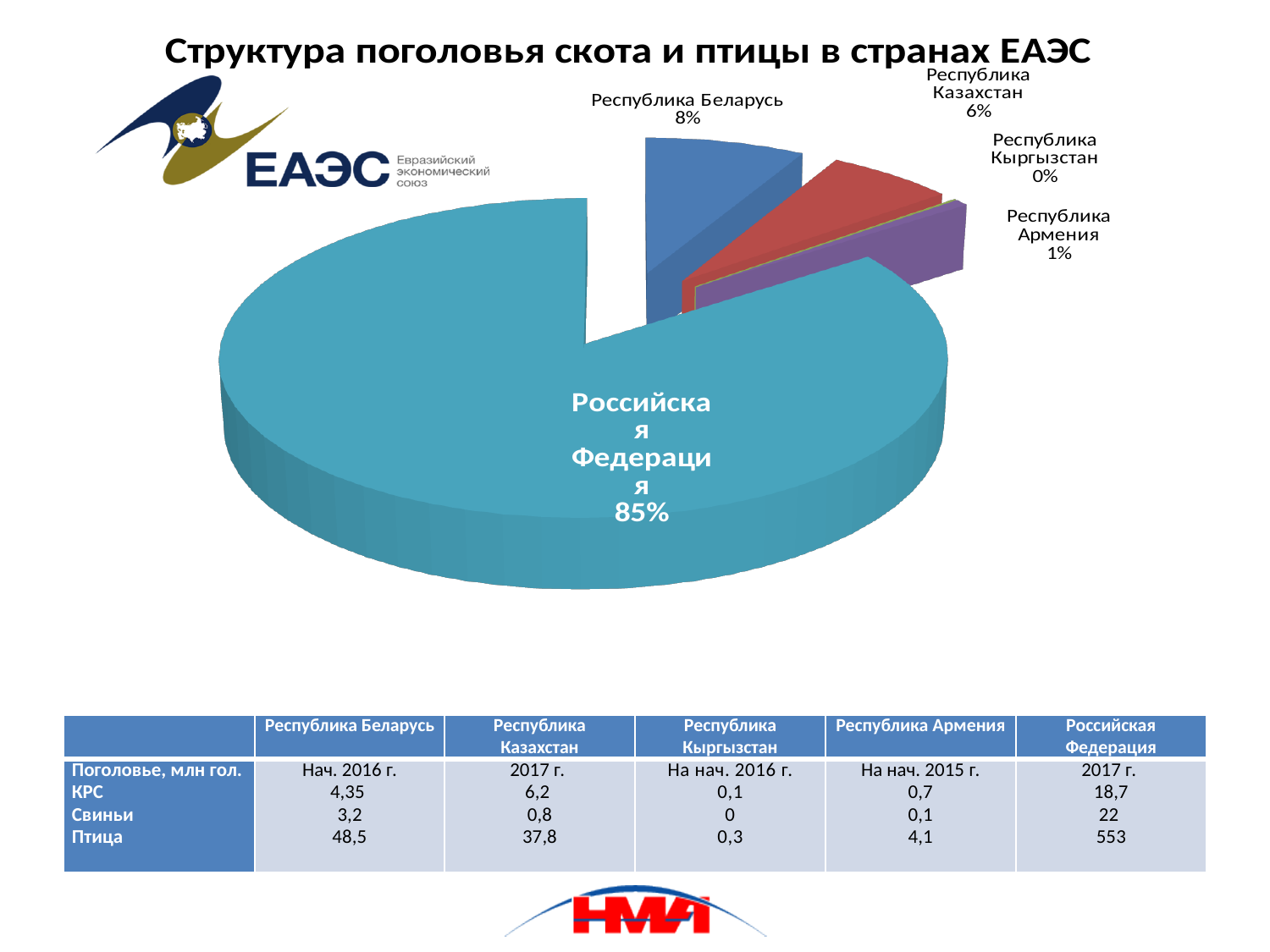
What is the difference in percentage points between the shares of Республика Беларусь and Республика Казахстан? 2 How many slices does the pie chart have? 5 Which country has the largest slice of the pie? Российская Федерация What share of the pie does Республика Казахстан hold? 6% Which slice is larger, Республика Беларусь or Республика Казахстан? Республика Беларусь What share of the pie does Российская Федерация hold? 85% What share of the pie does Республика Кыргызстан hold? 0% What is the title of the chart? Структура поголовья скота и птицы в странах ЕАЭС What kind of chart is shown on the slide? Pie chart Which country has the smallest slice of the pie? Республика Кыргызстан